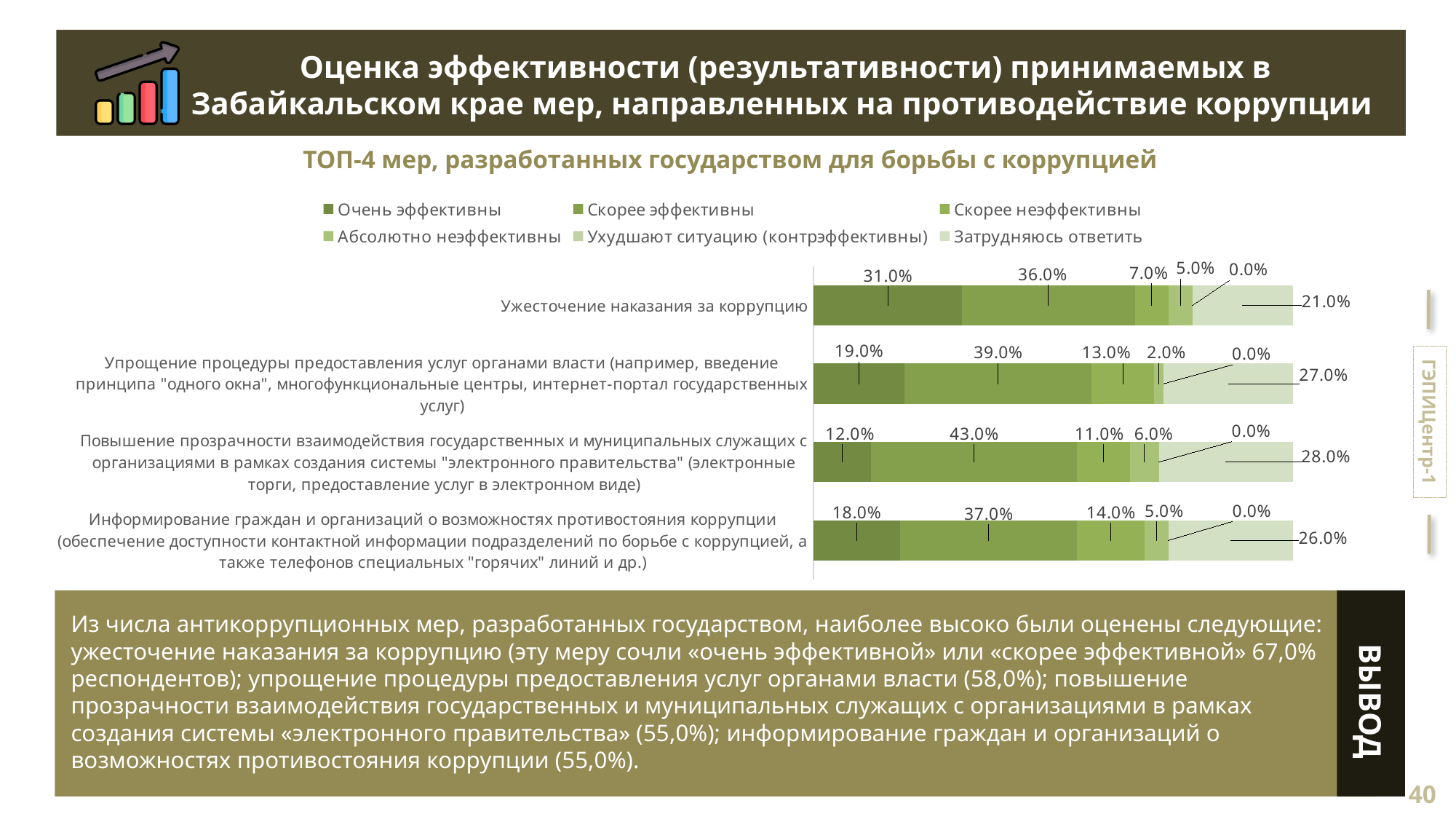
Which measure has the lowest "Очень эффективны" value? Повышение прозрачности взаимодействия государственных и муниципальных служащих с организациями в рамках создания системы "электронного правительства" What kind of chart is shown on the slide? Stacked bar chart How many measures (categories) are shown in the chart? 4 What share of respondents rated "Ужесточение наказания за коррупцию" as "Очень эффективны"? 31.0% Which is larger: the "Скорее неэффективны" value for "Информирование граждан..." or for "Упрощение процедуры..."? Информирование граждан... What is the "Скорее эффективны" value for "Повышение прозрачности взаимодействия государственных и муниципальных служащих с организациями..."? 43.0% Which measure has the highest "Очень эффективны" value? Ужесточение наказания за коррупцию What is the combined share of "Очень эффективны" and "Скорее эффективны" for "Ужесточение наказания за коррупцию"? 67.0% How many series does the legend list? 6 What is the difference between the "Скорее эффективны" values for "Повышение прозрачности..." (43.0%) and "Ужесточение наказания за коррупцию" (36.0%)? 7.0% What is the "Затрудняюсь ответить" value for "Упрощение процедуры предоставления услуг органами власти..."? 27.0% What is the "Абсолютно неэффективны" value for "Информирование граждан и организаций о возможностях противостояния коррупции..."? 5.0%